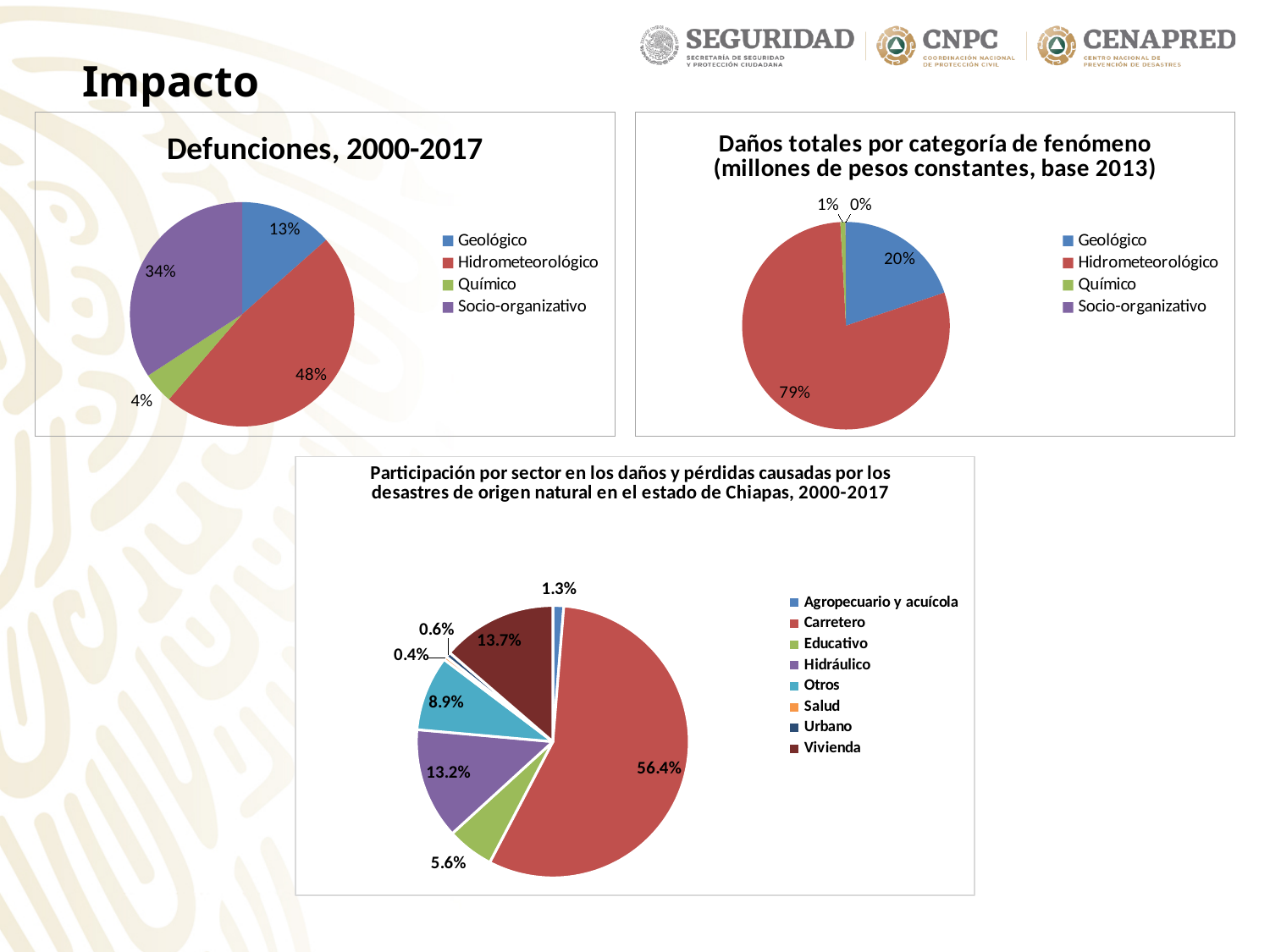
In the 'Daños totales por categoría de fenómeno' chart, what is the share for Geológico? 20% In the 'Participación por sector' chart at the bottom, what percentage corresponds to Carretero? 56.4% In the 'Participación por sector' chart at the bottom, which is larger, Vivienda or Hidráulico? Vivienda How many sectors does the legend of the 'Participación por sector' chart at the bottom list? 8 In the 'Daños totales por categoría de fenómeno' chart, what percentage corresponds to Hidrometeorológico? 79% In the 'Defunciones, 2000-2017' chart, which category has the smallest slice? Químico In the 'Daños totales por categoría de fenómeno' chart, which category has the largest share? Hidrometeorológico In the 'Defunciones, 2000-2017' chart, what is the difference between the Hidrometeorológico and Geológico shares? 35% In the 'Defunciones, 2000-2017' chart, what share of deaths is attributed to Hidrometeorológico? 48% In the 'Defunciones, 2000-2017' chart, what percentage corresponds to Socio-organizativo? 34% What type of chart is the 'Participación por sector' chart at the bottom of the slide? Pie chart How many series does the legend of the 'Daños totales por categoría de fenómeno' chart list? 4